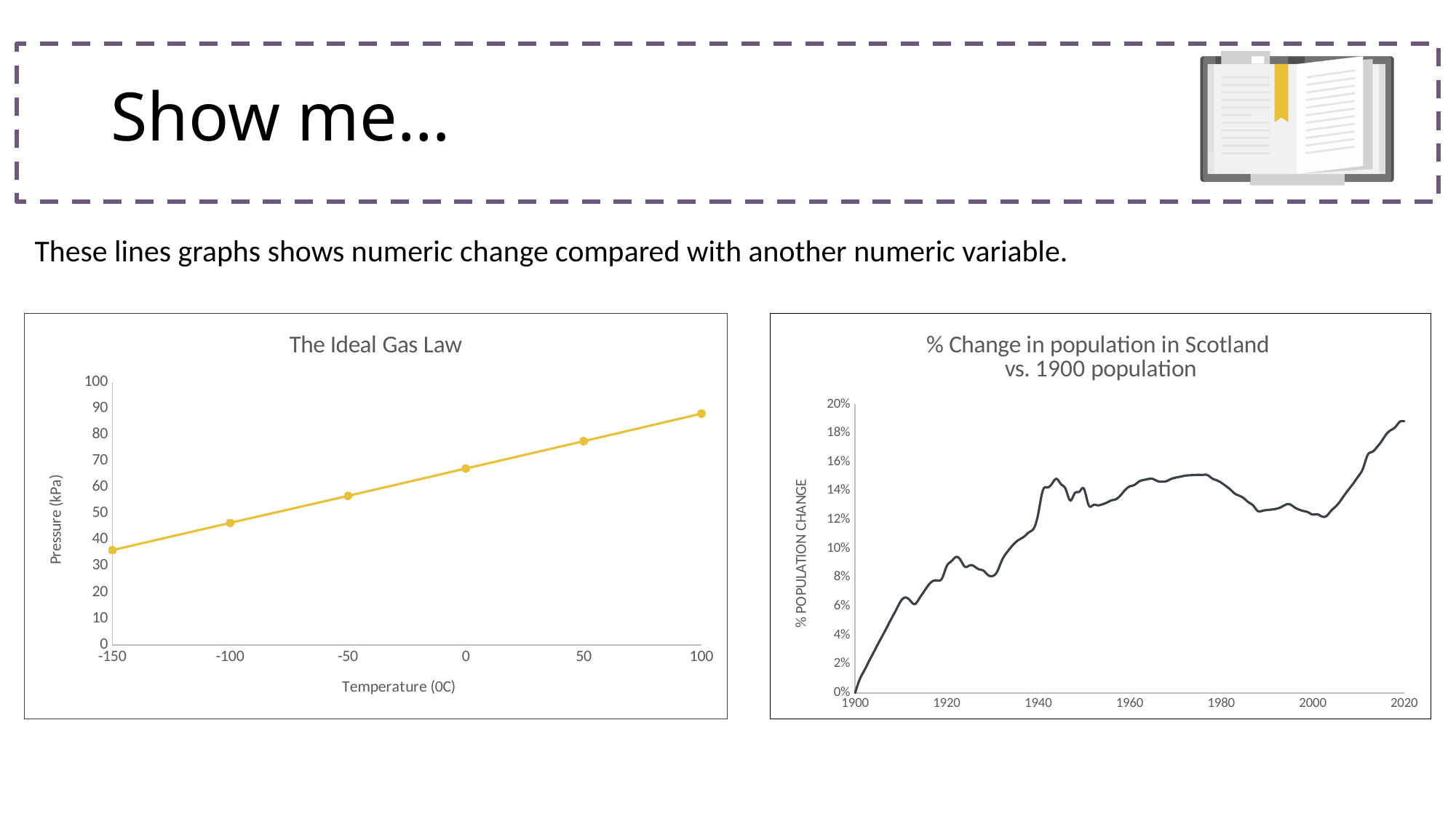
On 'The Ideal Gas Law' chart, does pressure rise or fall as temperature increases? rise What kind of chart is 'The Ideal Gas Law'? line chart On 'The Ideal Gas Law' chart, is the pressure at 100 greater or less than 80? greater On 'The Ideal Gas Law' chart, which has the larger pressure, 50 or -50? 50 What is the y-axis label on 'The Ideal Gas Law' chart? Pressure (kPa) On 'The Ideal Gas Law' chart, which temperature has the lowest pressure? -150 On the '% Change in population in Scotland vs. 1900 population' chart, what is the value for 1900? 0% On the '% Change in population in Scotland vs. 1900 population' chart, is the value for 2020 greater or less than 18%? greater How many data points are plotted on 'The Ideal Gas Law' chart? 6 On 'The Ideal Gas Law' chart, is the pressure at -150 greater or less than 40? less On 'The Ideal Gas Law' chart, which temperature has the highest pressure? 100